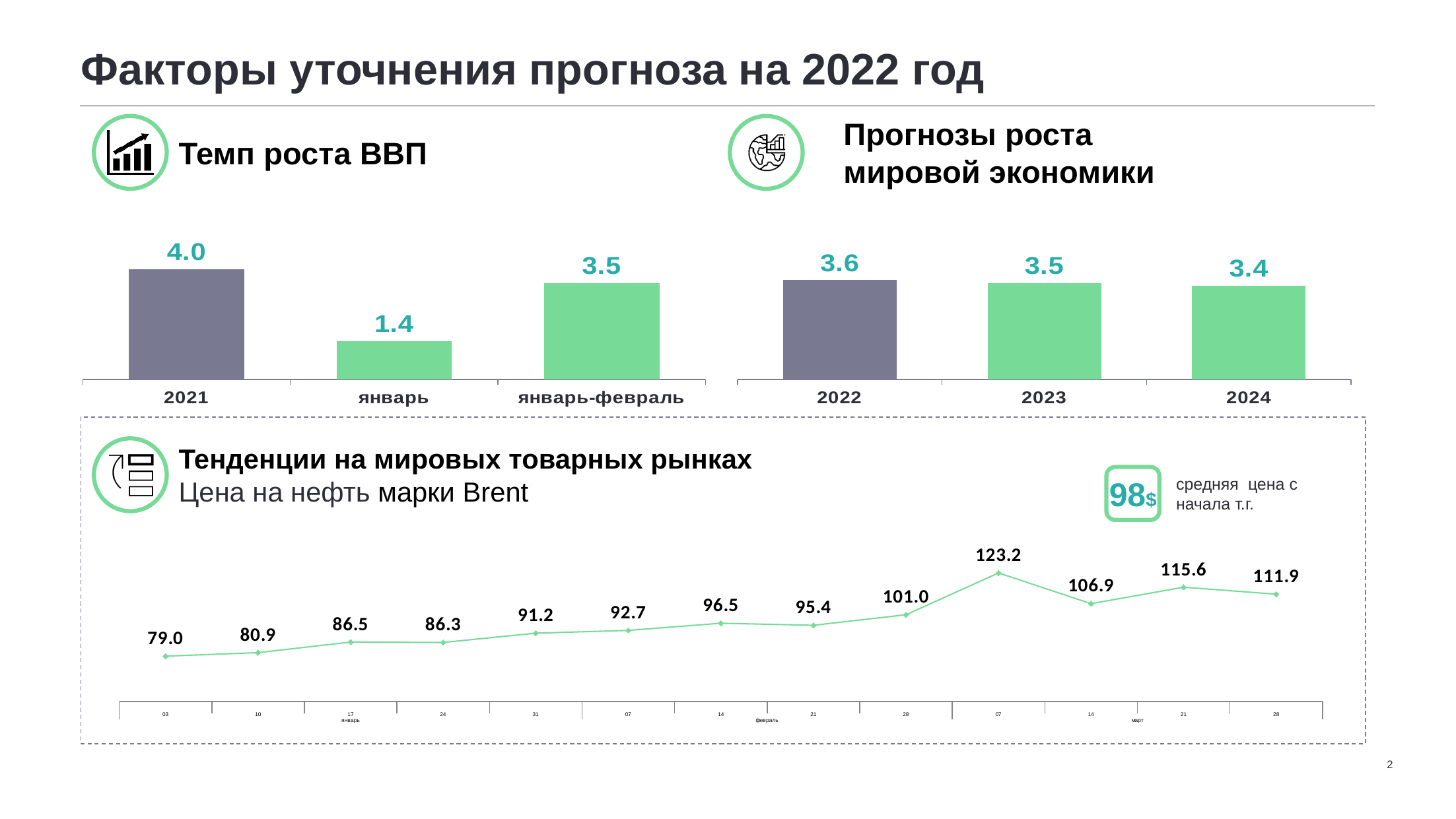
In the 'Прогнозы роста мировой экономики' chart, which year has the highest value? 2022 In the 'Цена на нефть марки Brent' chart, what is the difference between the last value (111.9) and the first value (79.0)? 32.9 In the 'Цена на нефть марки Brent' chart, what is the highest value shown? 123.2 In the 'Цена на нефть марки Brent' chart, what is the value at the first point (03 января)? 79.0 In the 'Темп роста ВВП' chart, what is the difference between the 2021 value and the январь value? 2.6 In the 'Темп роста ВВП' chart, how many bars are shown? 3 In the 'Цена на нефть марки Brent' chart, how many data points are plotted? 13 In the 'Темп роста ВВП' chart, which category has the lowest value? январь In the 'Темп роста ВВП' chart, what is the value for 2021? 4.0 What kind of chart is the 'Прогнозы роста мировой экономики' chart? bar chart In the 'Прогнозы роста мировой экономики' chart, what is the value for 2024? 3.4 In the 'Прогнозы роста мировой экономики' chart, do the values rise or fall from 2022 to 2024? fall